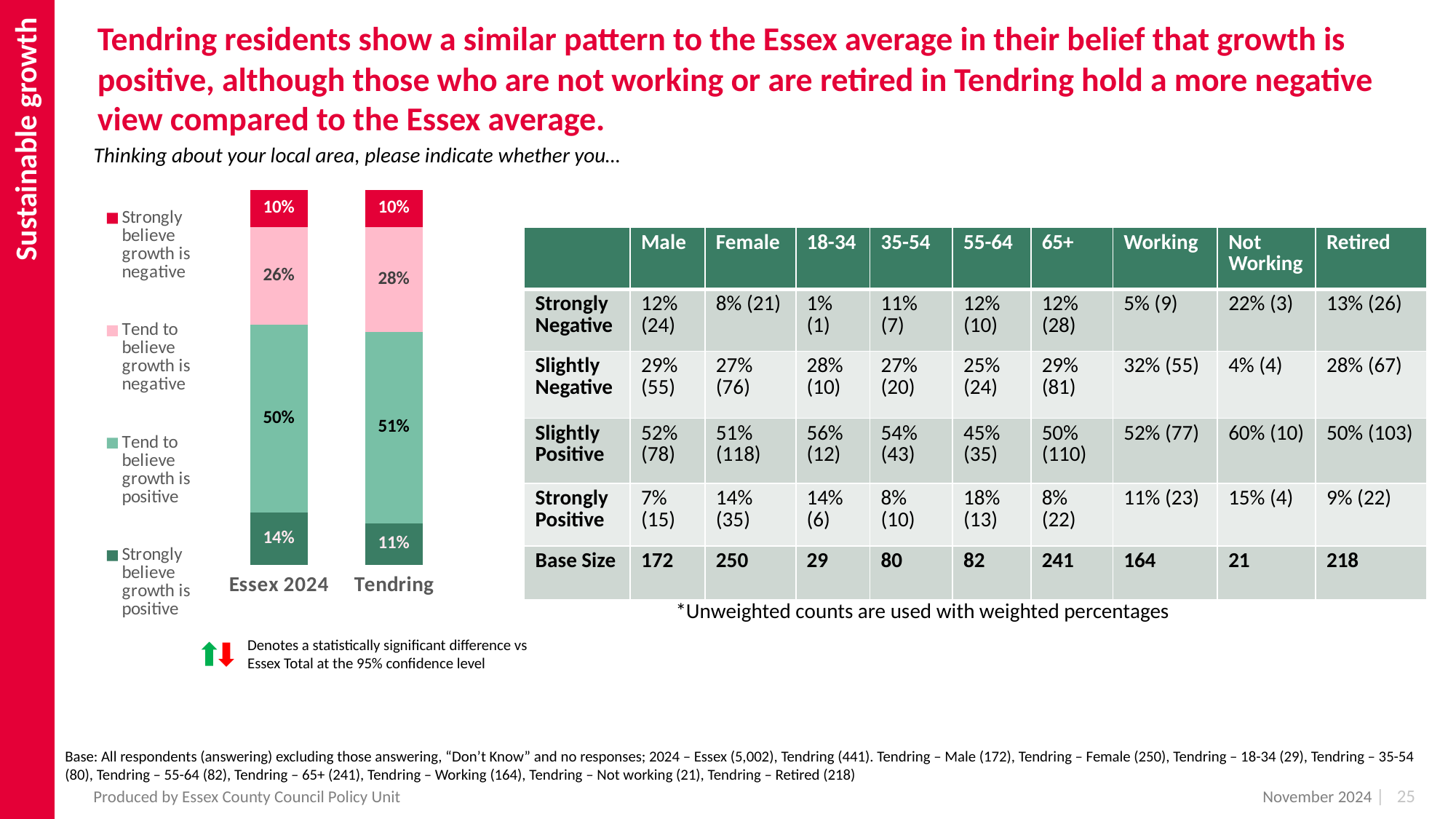
How many series does the chart legend list? 4 Which response category has the smallest share in the Essex 2024 bar? Strongly believe growth is negative What type of chart is shown on the slide? Stacked bar chart What is the difference between the Essex 2024 and Tendring percentages for 'Strongly believe growth is positive'? 3 percentage points Which has a higher percentage for 'Tend to believe growth is negative', Essex 2024 or Tendring? Tendring How many bars are shown in the chart? 2 What is the combined percentage of Tendring respondents who tend to or strongly believe growth is positive? 62% Which response category has the largest share in the Tendring bar? Tend to believe growth is positive What percentage of Tendring respondents strongly believe growth is positive? 11% What percentage of Tendring respondents tend to believe growth is negative? 28% What percentage of Essex 2024 respondents tend to believe growth is positive? 50% What percentage of Essex 2024 respondents strongly believe growth is negative? 10%